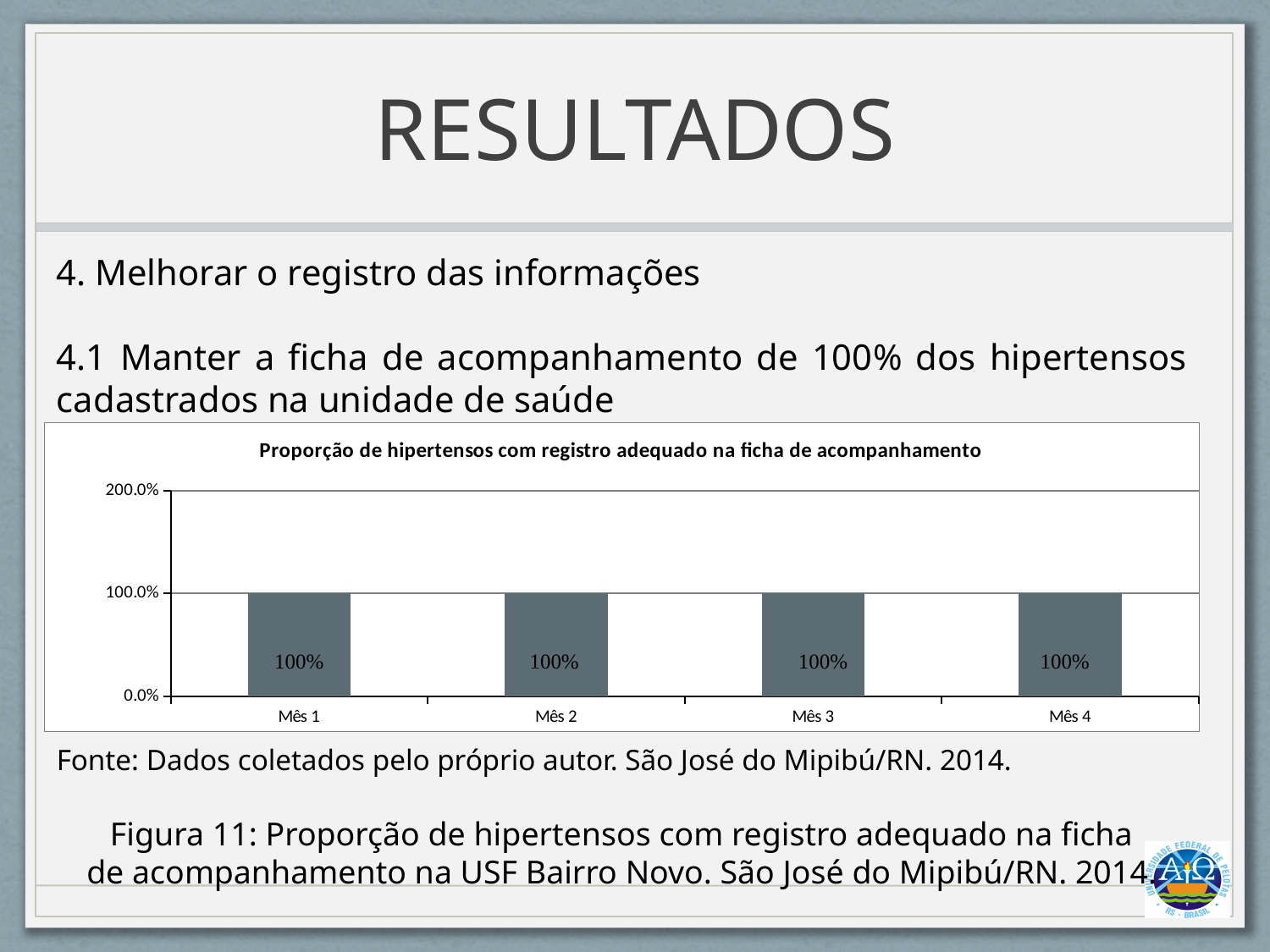
What is the highest tick value shown on the y axis? 200.0% What is the title of the chart? Proporção de hipertensos com registro adequado na ficha de acompanhamento Is the value for Mês 1 larger than, smaller than, or equal to the value for Mês 3? equal What is the value for Mês 1? 100% What is the difference between the values for Mês 2 and Mês 4? 0% How many categories are shown on the x axis? 4 Is the value for Mês 2 greater or less than 200.0%? less Do the values rise, fall, or stay the same from Mês 1 to Mês 4? stay the same What kind of chart is shown on the slide? bar chart What is the value for Mês 3? 100% What is the value for Mês 4? 100%